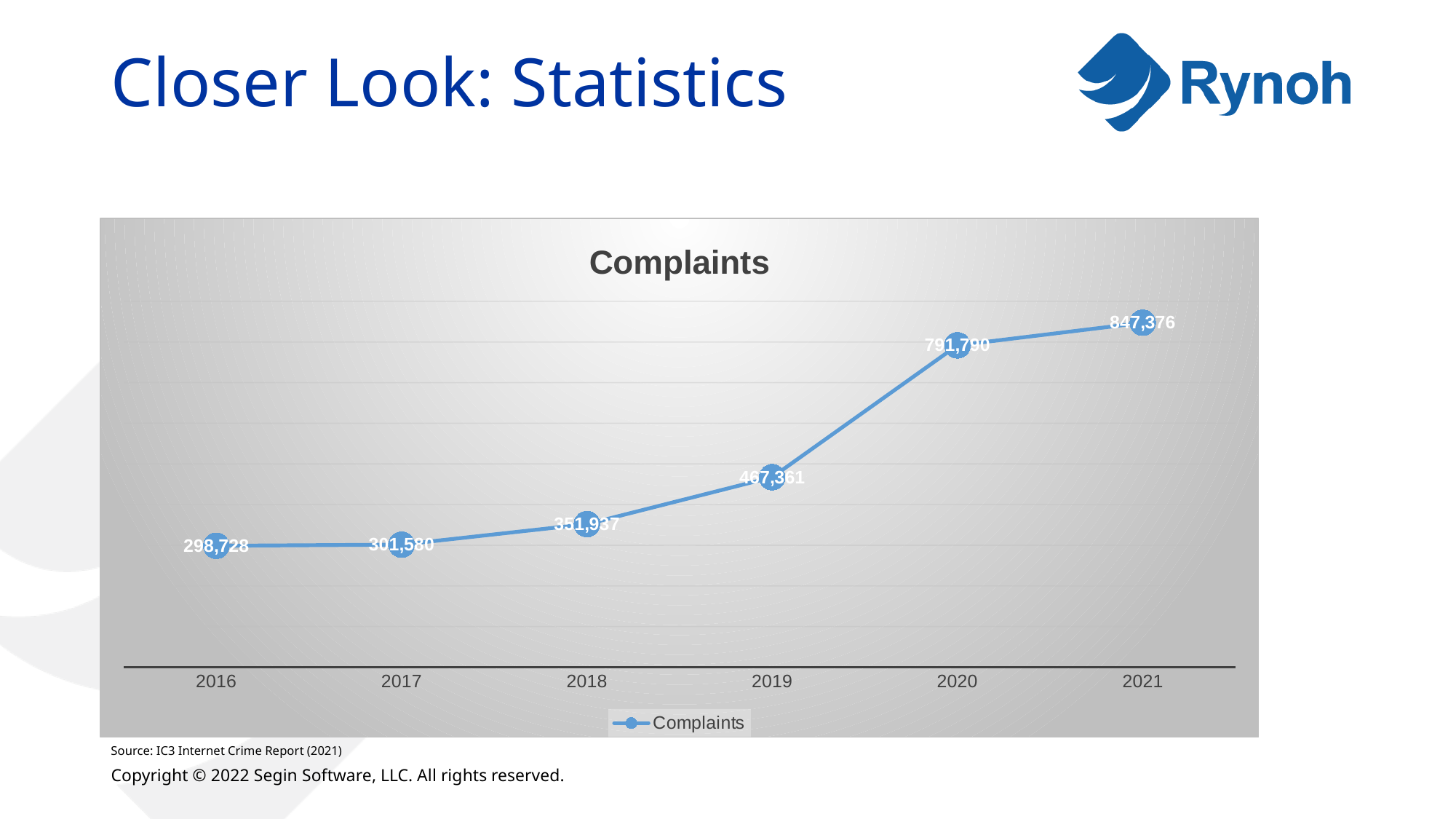
What is the difference in complaints between 2021 and 2016? 548,648 How many years are plotted on the chart? 6 What is the number of complaints in 2019? 467,361 Which year had more complaints, 2018 or 2017? 2018 Do complaints rise or fall from 2016 to 2021? Rise Which year has the highest number of complaints? 2021 How many series does the legend list? 1 What is the difference in complaints between 2020 and 2019? 324,429 What is the number of complaints in 2016? 298,728 Which year has the lowest number of complaints? 2016 What kind of chart is shown? Line chart What is the number of complaints in 2021? 847,376